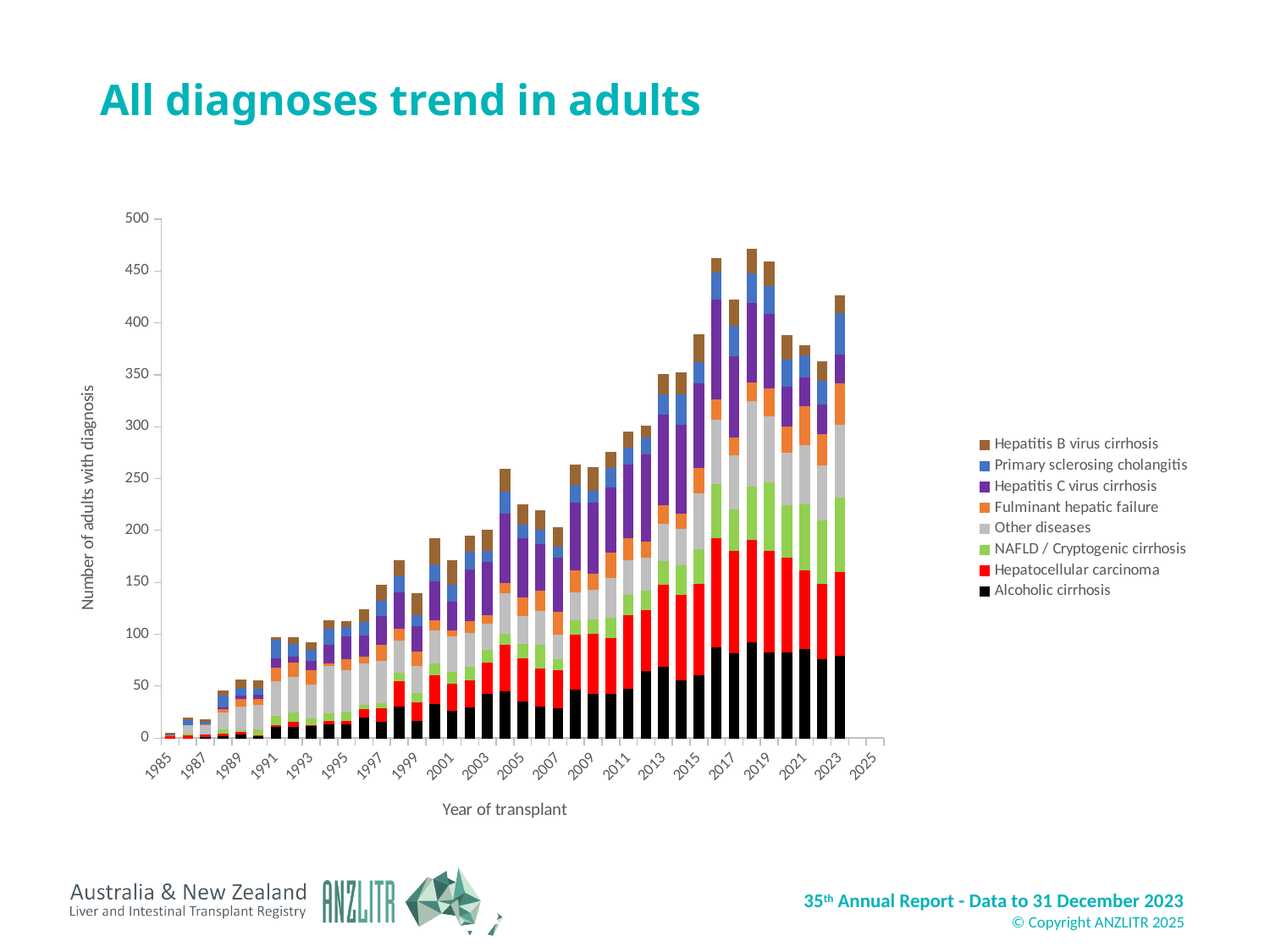
What kind of chart is shown on the slide? Stacked bar chart Which year has the lowest total number of adults with a diagnosis? 1985 Is the total number of adults with a diagnosis in 2016 greater or less than 450? greater Which year has the larger total bar, 2022 or 2023? 2023 Is the total number of adults with a diagnosis in 2023 greater or less than 400? greater Overall, do the total bar heights rise or fall from 1985 to 2023? Rise Which year has the larger total bar, 2017 or 2018? 2018 What is the label of the vertical axis? Number of adults with diagnosis Which diagnosis is shown in black at the bottom of each stacked bar? Alcoholic cirrhosis How many series does the legend list? 8 Is the total number of adults with a diagnosis in 2013 greater or less than 400? less